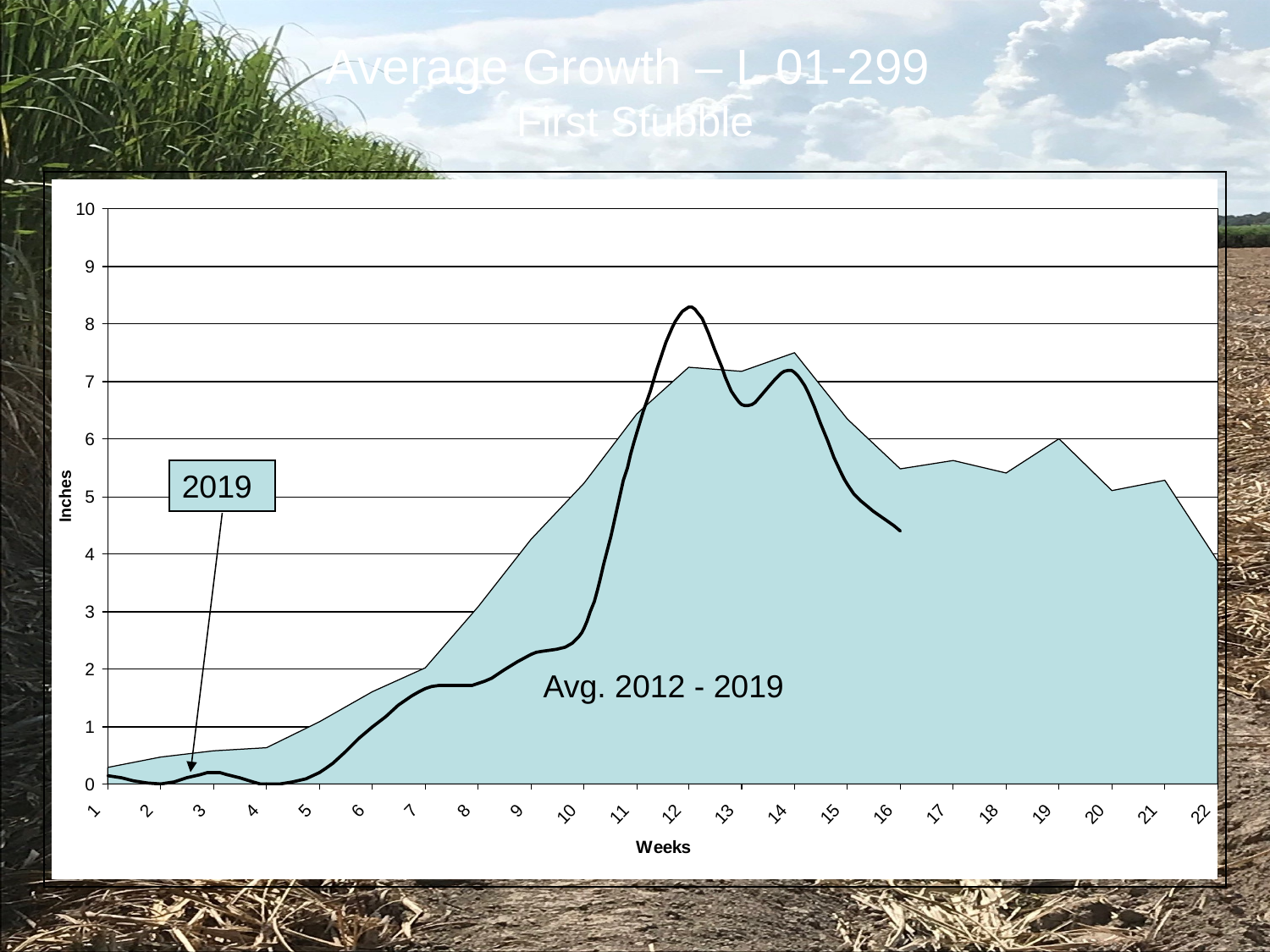
What is the title of the chart on the slide? Average Growth – L 01-299 First Stubble At which week does the 2019 series reach its highest value? 12 Is the Avg. 2012 - 2019 value at week 14 greater or less than 7? greater What is the label on the y axis? Inches Does the 2019 series rise or fall from week 14 to week 16? fall Is the 2019 value at week 16 greater or less than 5? less How many data series are plotted on the chart? 2 Is the 2019 value at week 12 greater or less than 8? greater What kind of chart is the Avg. 2012 - 2019 series drawn as? area chart How many weeks are shown on the x axis? 22 At week 12, which series has the larger value, 2019 or Avg. 2012 - 2019? 2019